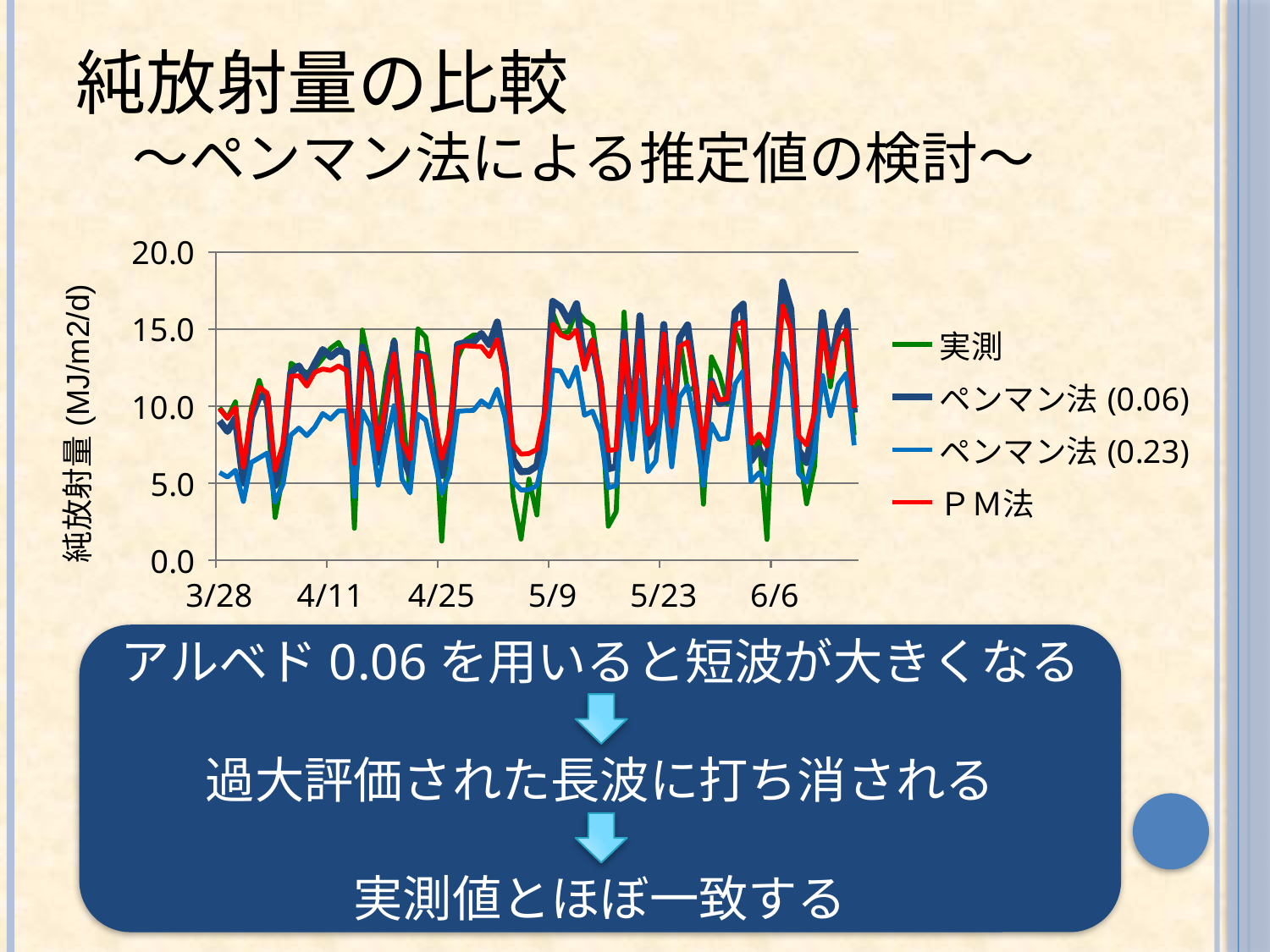
Is the highest value of ペンマン法 (0.23) greater or less than 15.0? less Around 6/6, which series has the larger peak value: ペンマン法 (0.06) or ペンマン法 (0.23)? ペンマン法 (0.06) Which series in the chart is drawn in red? ＰＭ法 What is the label of the y axis of the chart? 純放射量 (MJ/m2/d) Which series in the chart generally has the lowest values across the period? ペンマン法 (0.23) How many series does the chart's legend list? 4 Is the highest value of ペンマン法 (0.06) greater or less than 20.0? less Is the peak of ペンマン法 (0.06) around 6/6 greater or less than 15.0? greater How many date labels are shown along the x axis of the chart? 6 Which series reaches the highest peak value in the chart? ペンマン法 (0.06) What kind of chart is shown on the slide? line chart